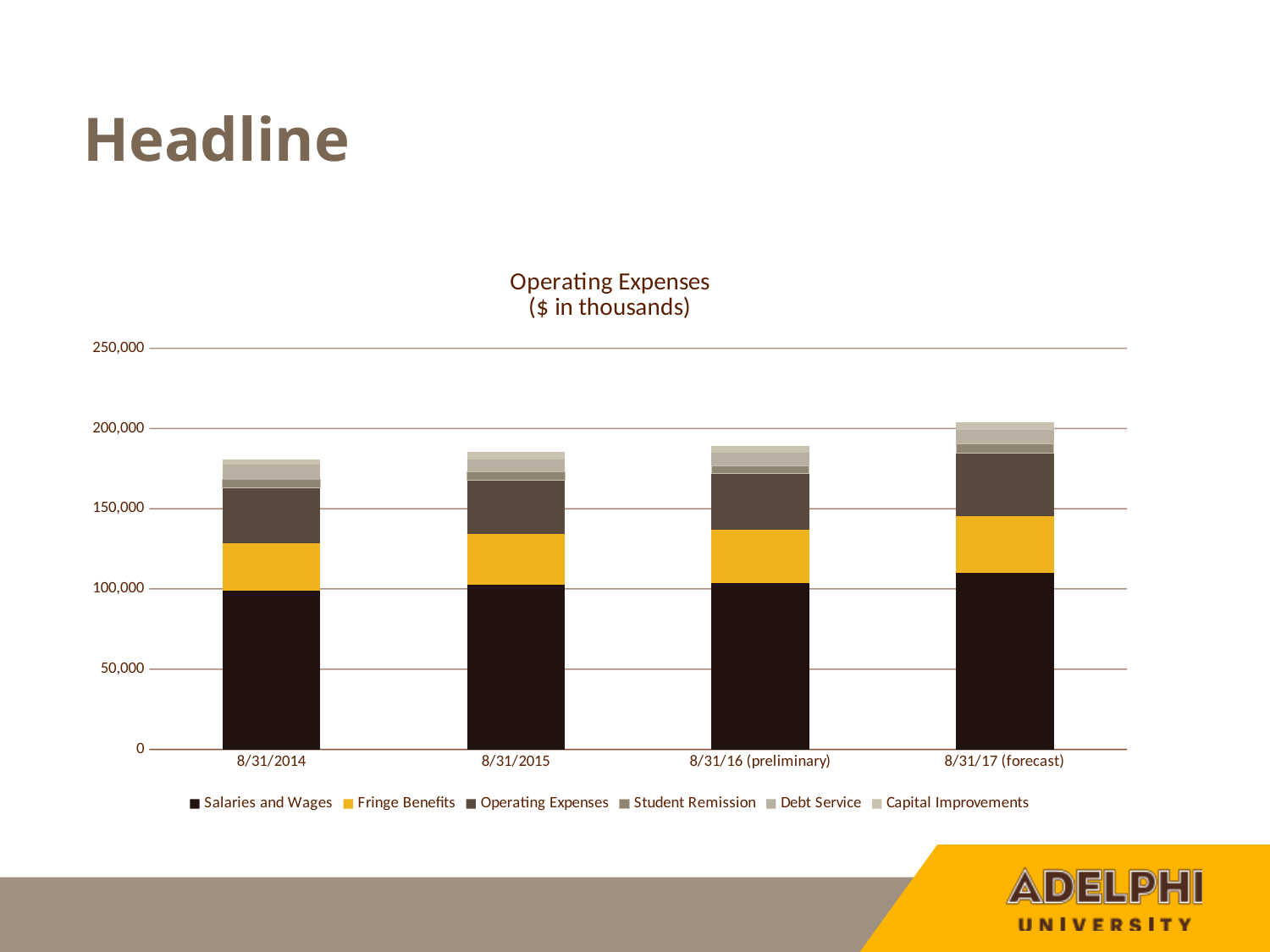
What kind of chart is shown on the slide? Stacked bar chart What is the title of the chart? Operating Expenses ($ in thousands) Is the Salaries and Wages segment for 8/31/17 (forecast) greater or less than 100,000? greater Which category has the shortest total bar? 8/31/2014 Do the total operating expenses rise or fall from 8/31/2014 to 8/31/17 (forecast)? rise Is the total bar for 8/31/2015 greater or less than 150,000? greater Is the total bar for 8/31/2014 greater or less than 200,000? less Which category has the tallest total bar? 8/31/17 (forecast) Which total bar is larger, 8/31/2014 or 8/31/17 (forecast)? 8/31/17 (forecast) How many bars (fiscal year categories) are shown on the x axis? 4 How many series does the legend list? 6